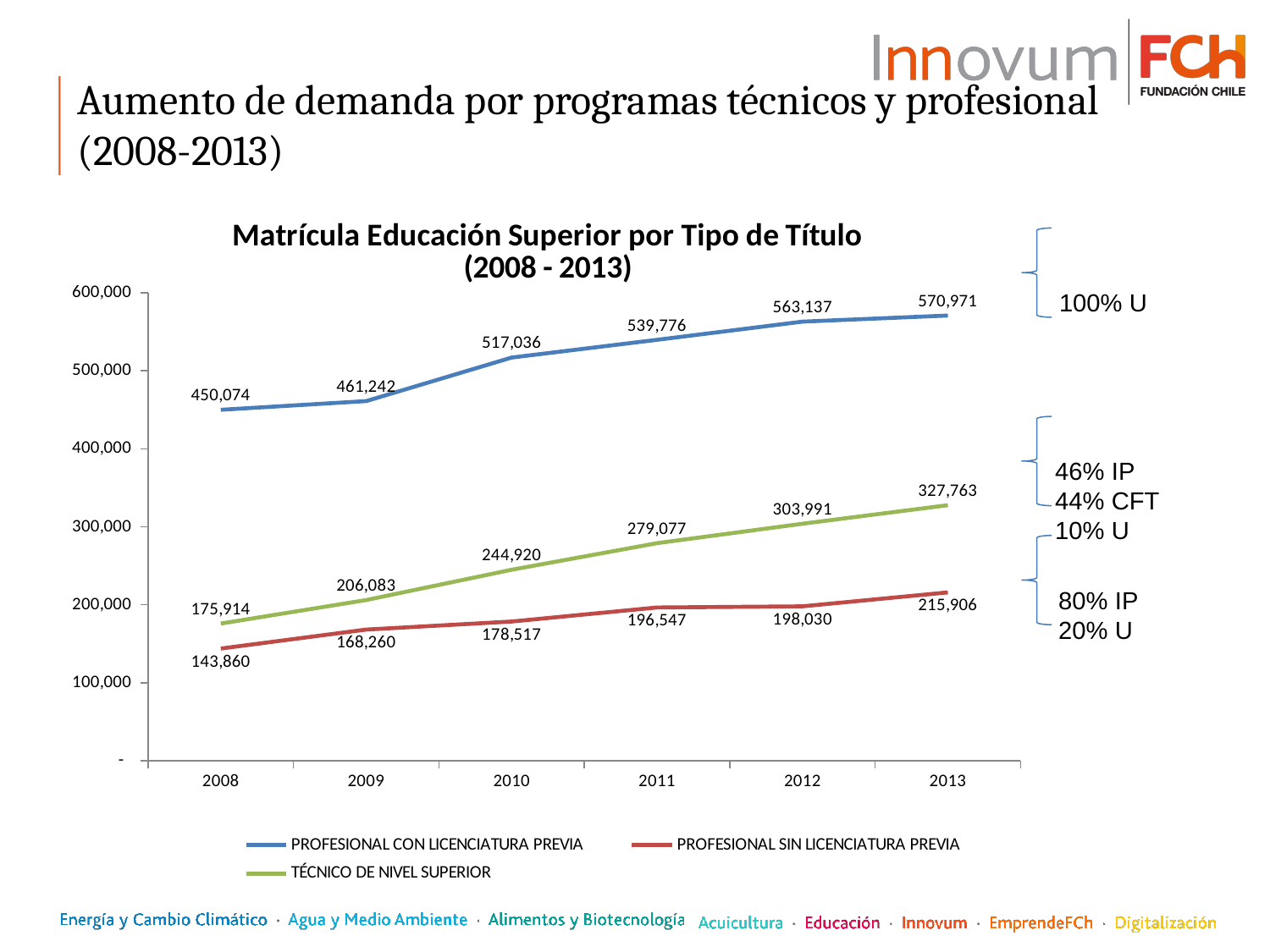
In which year is the value for TÉCNICO DE NIVEL SUPERIOR highest? 2013 What is the value for TÉCNICO DE NIVEL SUPERIOR in 2010? 244,920 Do the values for PROFESIONAL SIN LICENCIATURA PREVIA rise or fall from 2008 to 2013? Rise What is the title of the chart? Matrícula Educación Superior por Tipo de Título (2008 - 2013) What is the difference between the 2013 and 2008 values for TÉCNICO DE NIVEL SUPERIOR? 151,849 In which year is the value for PROFESIONAL CON LICENCIATURA PREVIA lowest? 2008 How many years are shown on the x axis? 6 Which series has the larger value in 2012, TÉCNICO DE NIVEL SUPERIOR or PROFESIONAL SIN LICENCIATURA PREVIA? TÉCNICO DE NIVEL SUPERIOR How many series does the legend list? 3 What type of chart is shown on the slide? Line chart What is the value for PROFESIONAL CON LICENCIATURA PREVIA in 2013? 570,971 What is the value for PROFESIONAL SIN LICENCIATURA PREVIA in 2008? 143,860